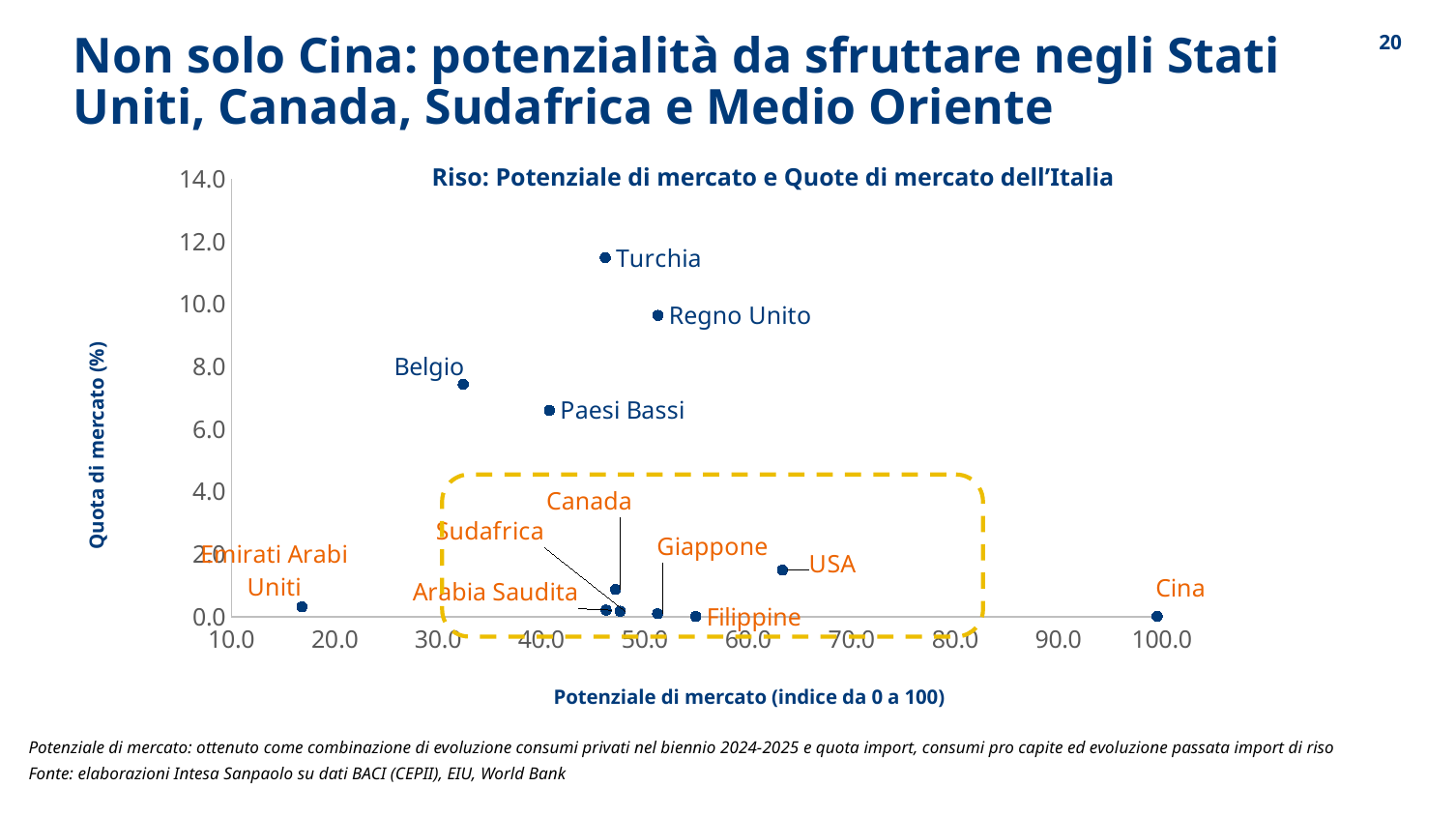
Is the market potential (Potenziale di mercato) for Cina greater or less than 90.0? greater What kind of chart is shown on the slide? Scatter chart Which country has the highest market potential (Potenziale di mercato) in the chart? Cina Which has a higher market share (Quota di mercato), Regno Unito or Paesi Bassi? Regno Unito What is the title of the chart? Riso: Potenziale di mercato e Quote di mercato dell'Italia Is the market share (Quota di mercato) for Turchia greater or less than 10.0? greater Which country has the lowest market potential (Potenziale di mercato) in the chart? Emirati Arabi Uniti Which country has the highest market share (Quota di mercato) in the chart? Turchia Is the market share (Quota di mercato) for Belgio greater or less than 8.0? less What is the label of the vertical axis? Quota di mercato (%) Which has a higher market potential (Potenziale di mercato), USA or Belgio? USA How many countries are plotted in the chart? 12